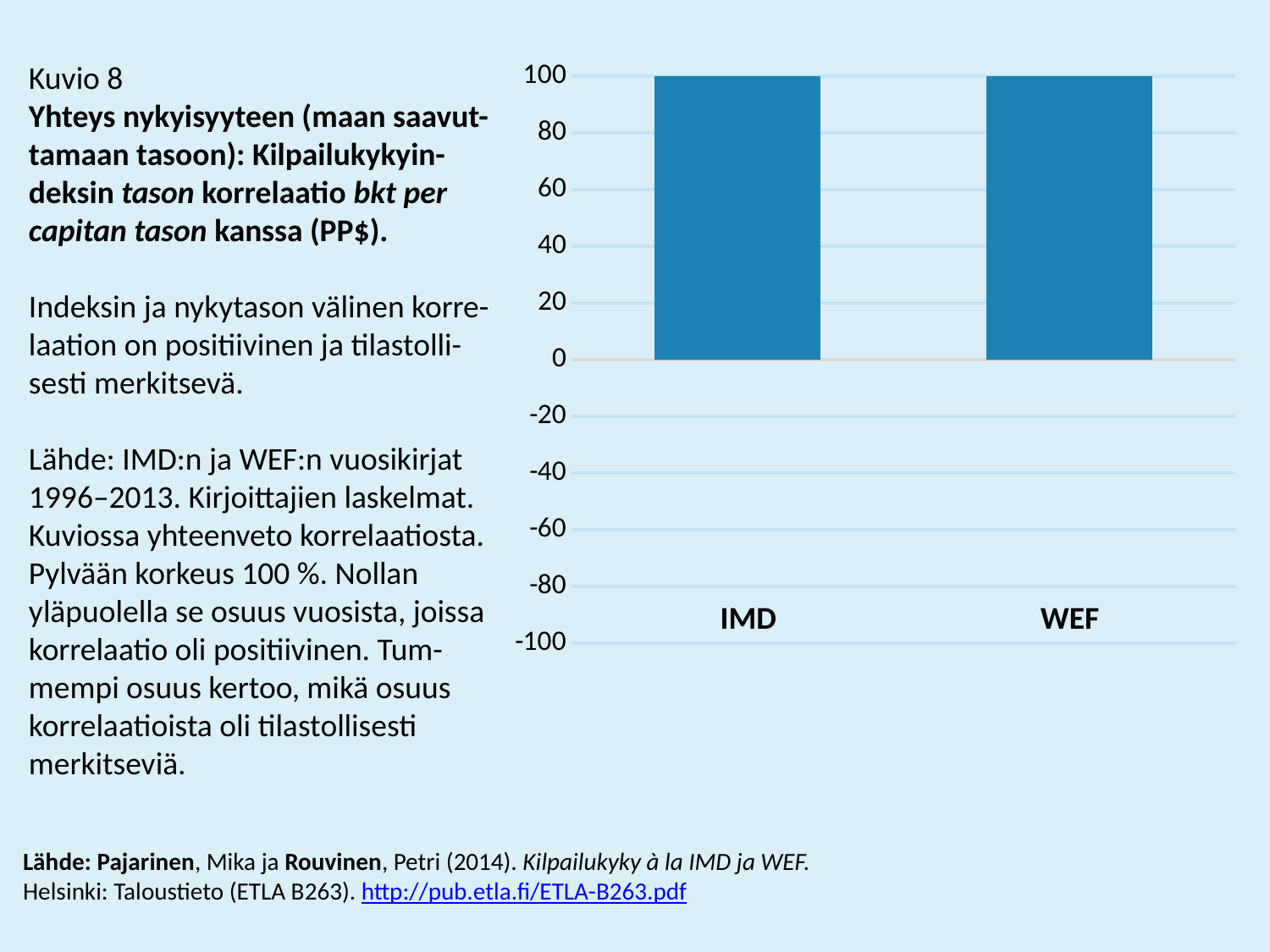
How many bars are plotted in the chart? 2 Are the IMD and WEF bars the same height? yes What are the two categories on the x axis of the chart? IMD and WEF What is the lowest value shown on the y axis of the chart? -100 Is the value for IMD greater or less than 60? greater What kind of chart is shown on the slide? bar chart Do any bars extend below zero on the chart? no What value does the IMD bar reach on the y axis? 100 Is the value for WEF greater or less than 40? greater What value does the WEF bar reach on the y axis? 100